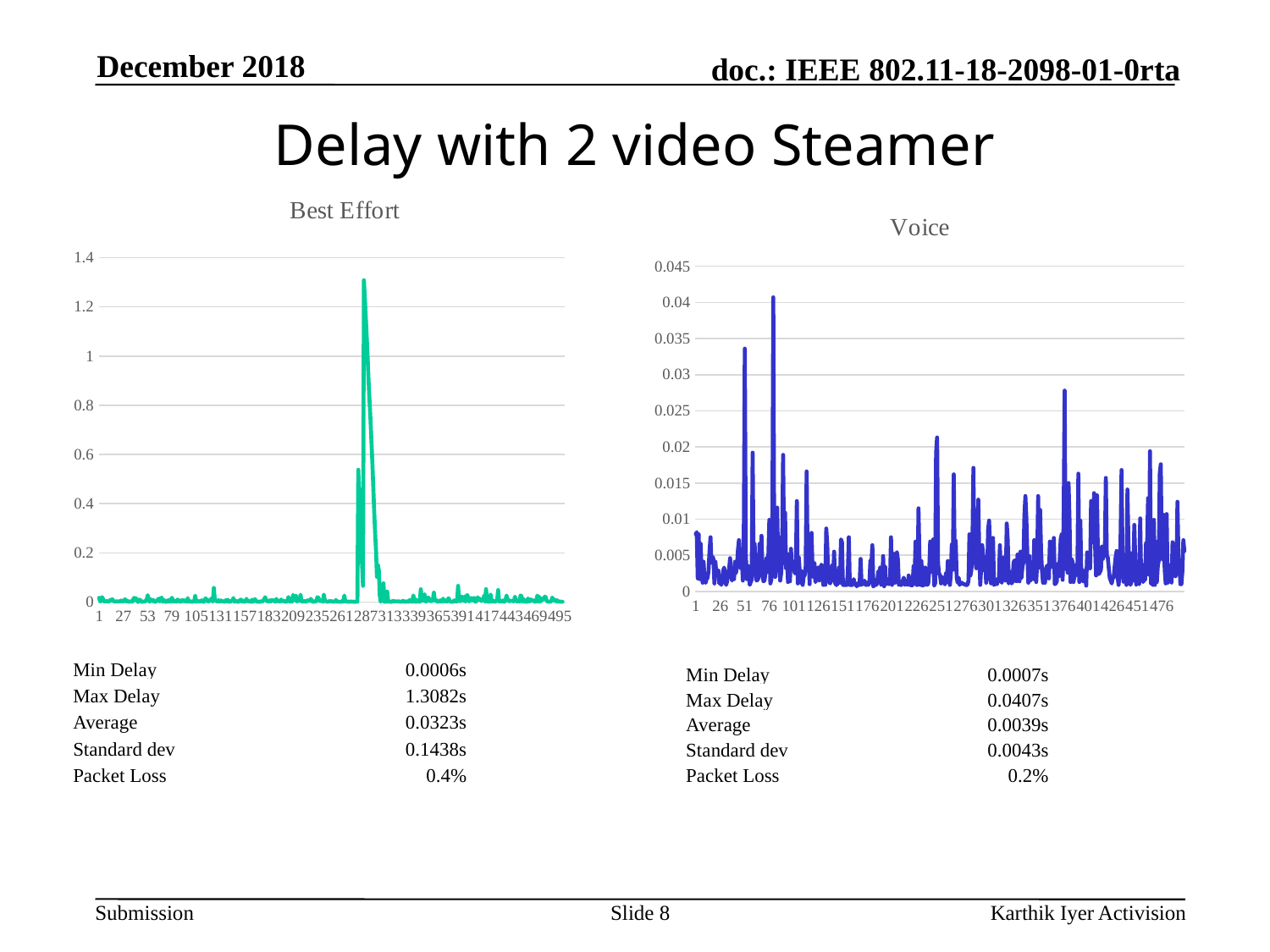
On the Best Effort chart, is the highest peak greater or less than 1.2? greater How many charts are shown on the slide? 2 On the Voice chart, is the spike near x = 51 greater or less than 0.03? greater On the Voice chart, is the highest peak greater or less than 0.045? less What colour is the line plotted on the Voice chart? blue What kind of chart is the Voice chart? line chart What kind of chart is the Best Effort chart? line chart What is the title of the chart on the left side of the slide? Best Effort Which chart reaches a higher peak delay value, Best Effort or Voice? Best Effort